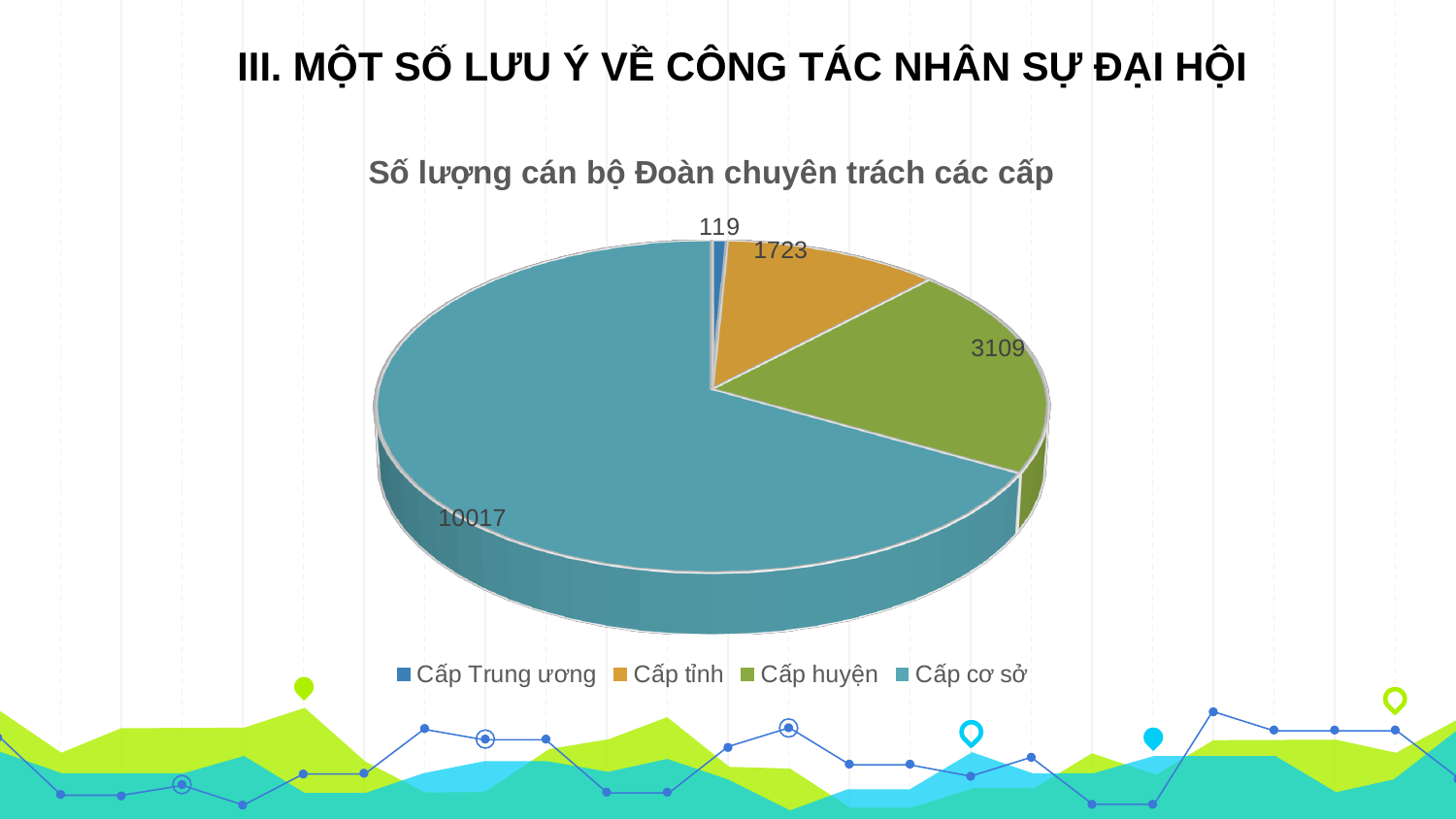
Which category has the largest slice of the pie? Cấp cơ sở What is the total of all four slices in the pie chart? 14968 What is the difference between the values for Cấp huyện and Cấp tỉnh? 1386 Which category has the smallest slice of the pie? Cấp Trung ương What kind of chart is shown on the slide? Pie chart What is the value for Cấp huyện? 3109 What is the value for Cấp Trung ương? 119 How many categories does the pie chart show? 4 What is the value for Cấp cơ sở? 10017 What is the title of the chart? Số lượng cán bộ Đoàn chuyên trách các cấp Which is larger, the value for Cấp tỉnh or the value for Cấp huyện? Cấp huyện What is the value for Cấp tỉnh? 1723